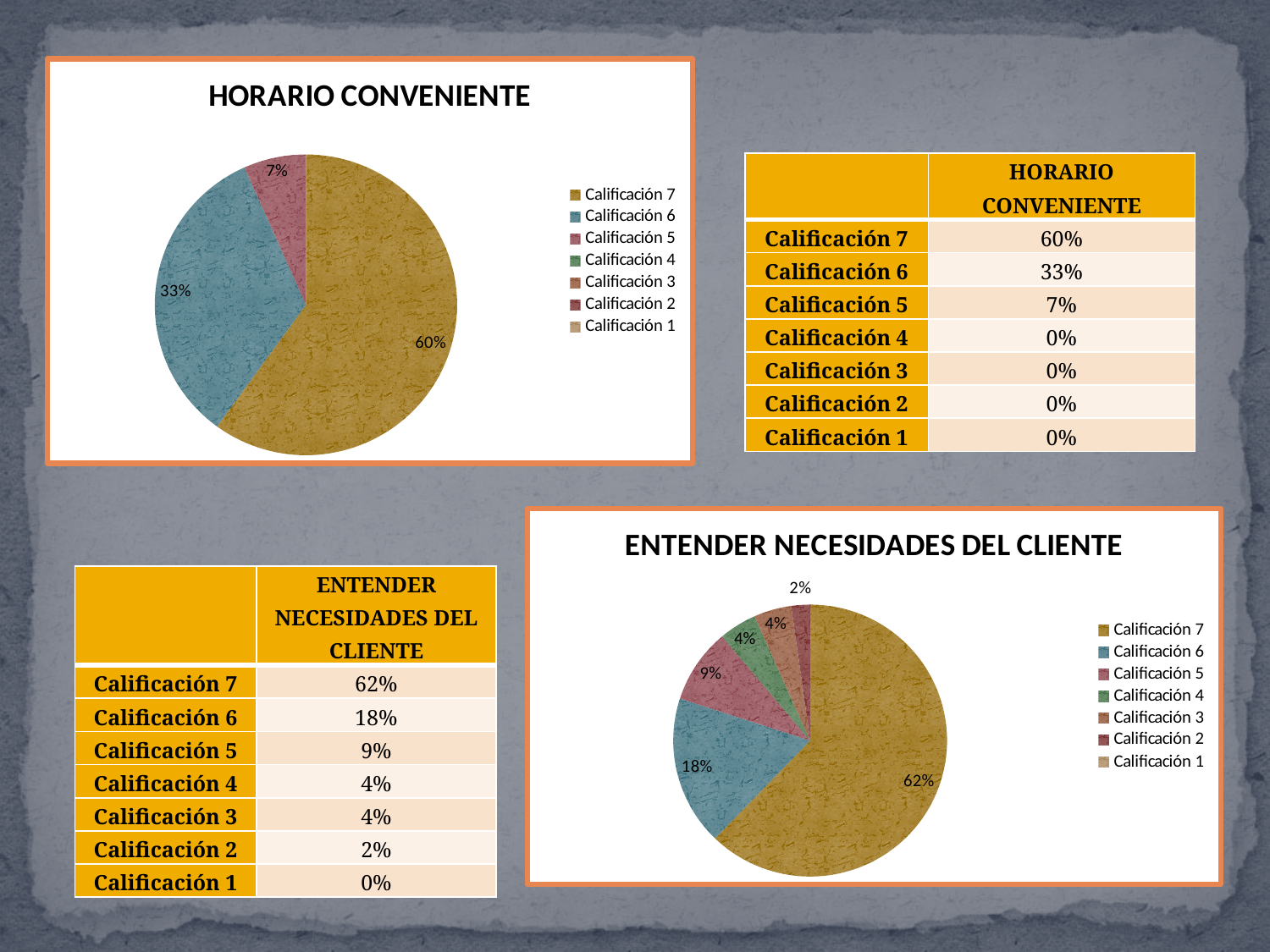
In the ENTENDER NECESIDADES DEL CLIENTE chart, what share of the pie does Calificación 7 have? 62% In the HORARIO CONVENIENTE chart, how many entries does the legend list? 7 In the ENTENDER NECESIDADES DEL CLIENTE chart, what share of the pie does Calificación 6 have? 18% In the HORARIO CONVENIENTE chart, what share of the pie does Calificación 7 have? 60% In the ENTENDER NECESIDADES DEL CLIENTE chart, what is the difference between the shares of Calificación 7 and Calificación 6? 44% In the HORARIO CONVENIENTE chart, what share of the pie does Calificación 5 have? 7% In the HORARIO CONVENIENTE chart, which category has the largest slice? Calificación 7 In the ENTENDER NECESIDADES DEL CLIENTE chart, which is larger, the slice for Calificación 6 or the slice for Calificación 5? Calificación 6 In the HORARIO CONVENIENTE chart, what share of the pie does Calificación 6 have? 33% What kind of chart is the ENTENDER NECESIDADES DEL CLIENTE chart? pie chart In the HORARIO CONVENIENTE chart, what is the difference between the shares of Calificación 7 and Calificación 6? 27% In the ENTENDER NECESIDADES DEL CLIENTE chart, what share of the pie does Calificación 2 have? 2%